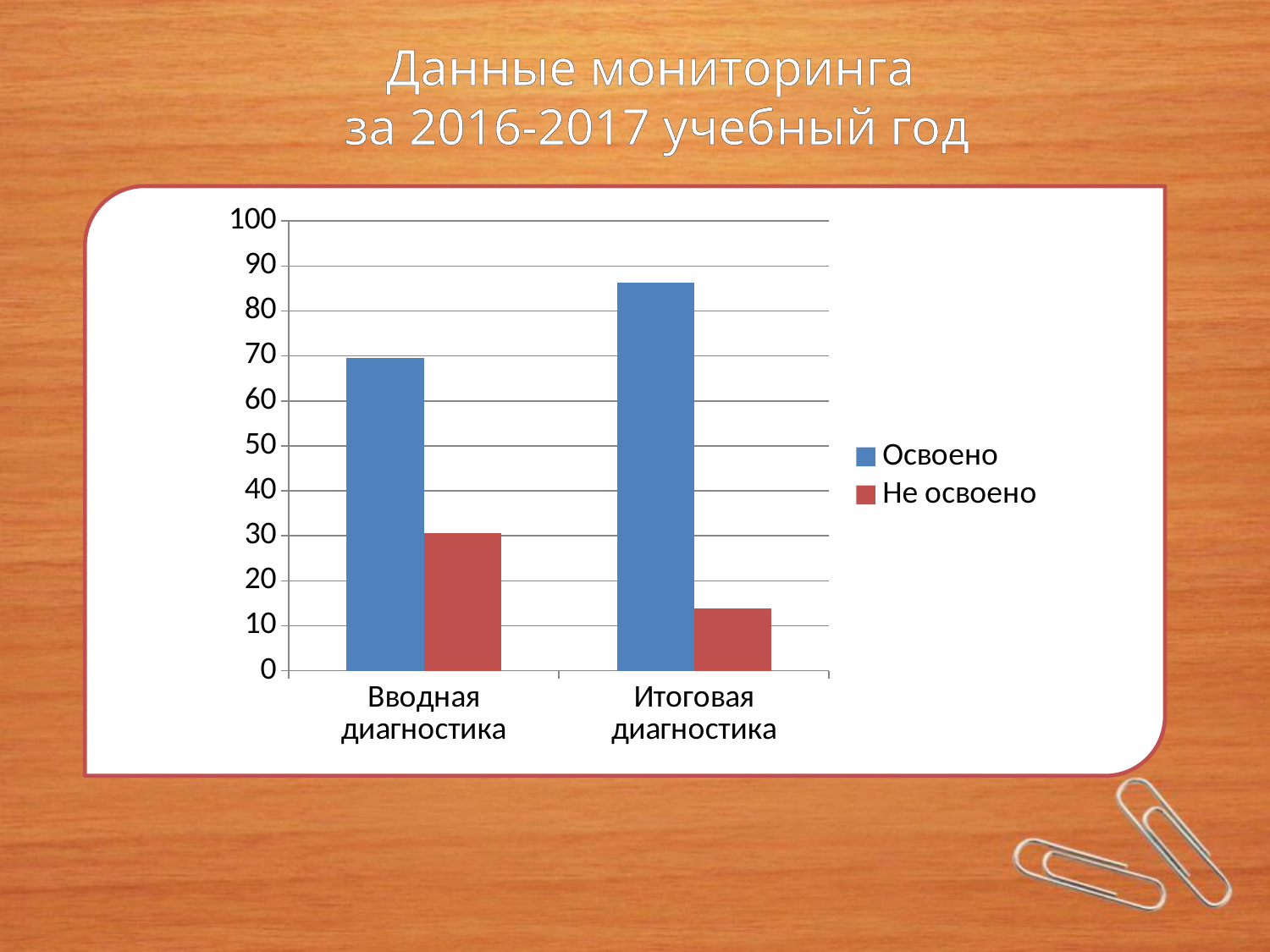
Which category has the higher value for Освоено? Итоговая диагностика What kind of chart is shown on the slide? bar chart Is the value for Освоено in Итоговая диагностика greater or less than 80? greater Is the value for Освоено in Вводная диагностика greater or less than 60? greater How many series does the legend list? 2 Which series does the blue bar represent? Освоено How many categories are shown on the x axis? 2 Does the Освоено series rise or fall from Вводная диагностика to Итоговая диагностика? rise Is the value for Не освоено in Итоговая диагностика greater or less than 20? less What is the title of the slide? Данные мониторинга за 2016-2017 учебный год Which category has the lower value for Не освоено? Итоговая диагностика